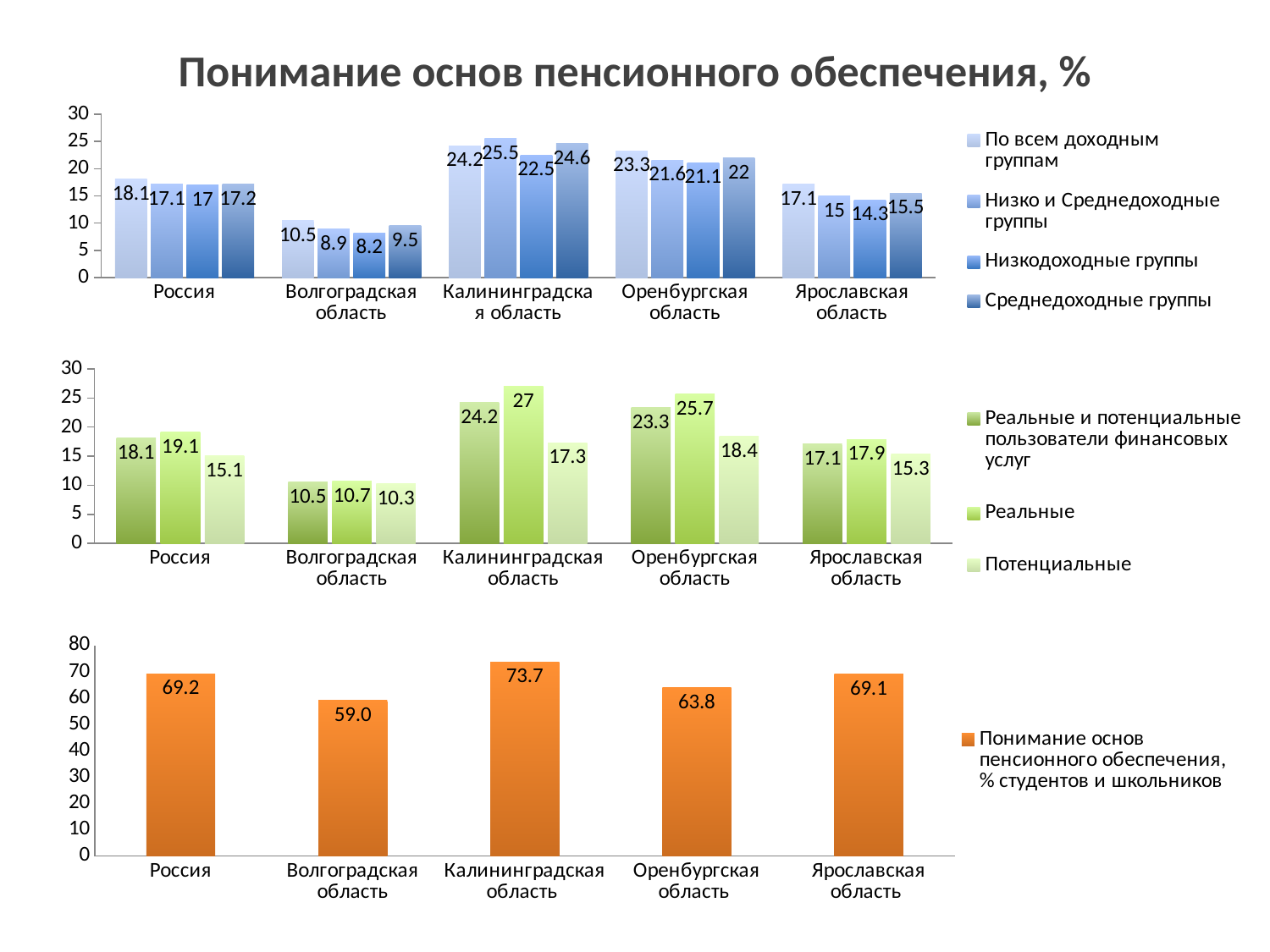
In the top chart, what is the difference between the 'По всем доходным группам' values for Оренбургская область and Ярославская область? 6.2 In the top chart, which region has the lowest value for 'Низкодоходные группы'? Волгоградская область In the top chart, what is the value for Калининградская область in the series 'Низко и Среднедоходные группы'? 25.5 What type of chart is the bottom chart? Bar chart In the bottom chart, what is the difference between the values for Калининградская область and Оренбургская область? 9.9 In the top chart, how many series does the legend list? 4 In the middle chart, what is the value for Оренбургская область in the series 'Реальные'? 25.7 In the middle chart, which region has the highest value for 'Потенциальные'? Оренбургская область In the bottom chart, what is the value for Волгоградская область? 59.0 In the middle chart, how many regions are shown on the x axis? 5 In the bottom chart, which region has the highest value? Калининградская область In the middle chart, which is larger for Россия: 'Реальные' or 'Потенциальные'? Реальные